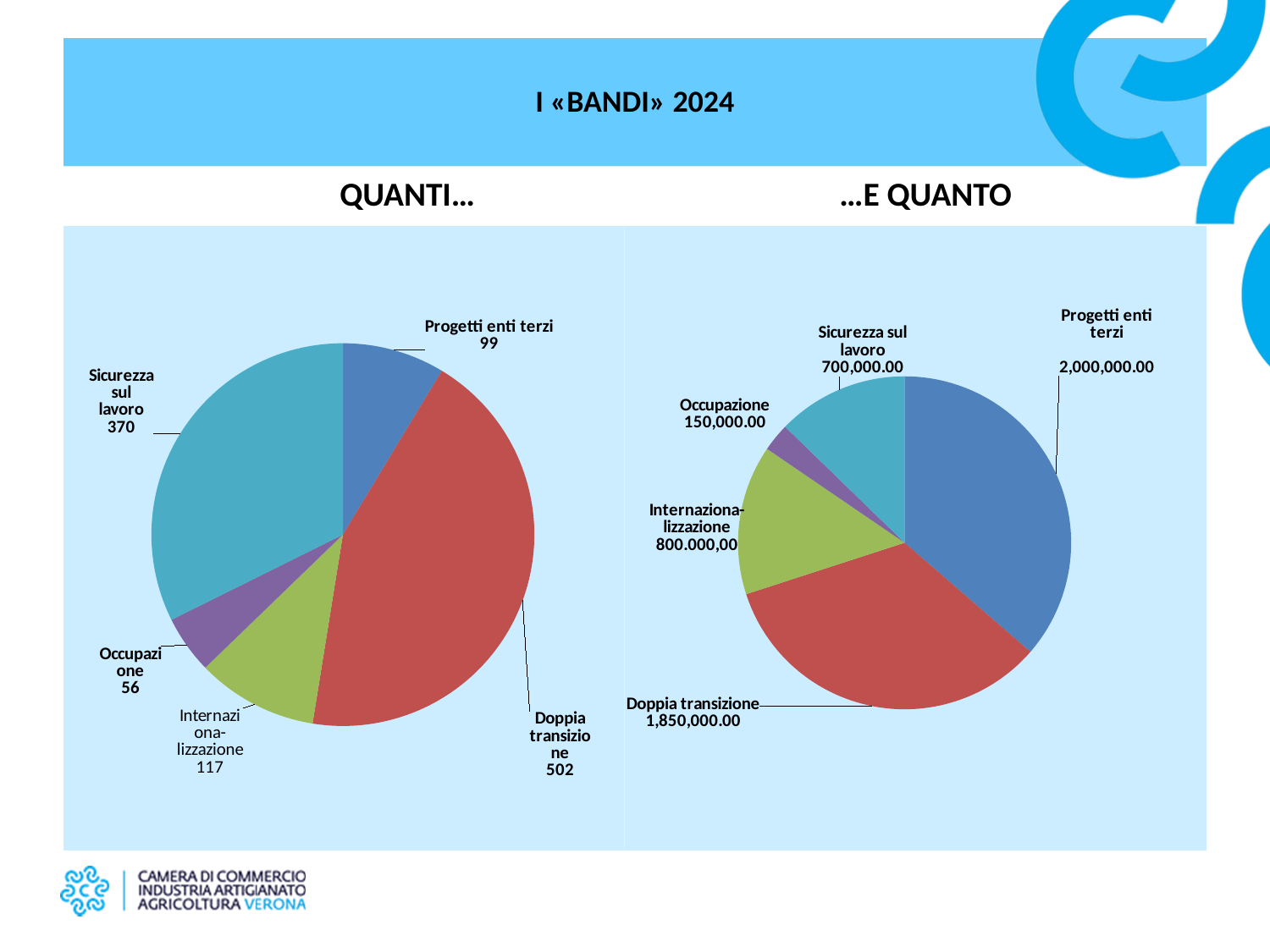
In the left pie chart (QUANTI...), what is the value for Doppia transizione? 502 In the left pie chart (QUANTI...), what is the value for Sicurezza sul lavoro? 370 In the left pie chart (QUANTI...), which category has the largest value? Doppia transizione In the right pie chart (...E QUANTO), which category has the largest value? Progetti enti terzi In the left pie chart (QUANTI...), which category has the smallest value? Occupazione In the right pie chart (...E QUANTO), which category has the smallest value? Occupazione What type of chart is used on the right side of the slide (...E QUANTO)? Pie chart In the right pie chart (...E QUANTO), which is larger, Sicurezza sul lavoro or Internazionalizzazione? Internazionalizzazione In the right pie chart (...E QUANTO), what is the value for Progetti enti terzi? 2,000,000.00 In the left pie chart (QUANTI...), what is the difference between Doppia transizione and Sicurezza sul lavoro? 132 In the right pie chart (...E QUANTO), what is the value for Occupazione? 150,000.00 How many slices does the left pie chart (QUANTI...) have? 5